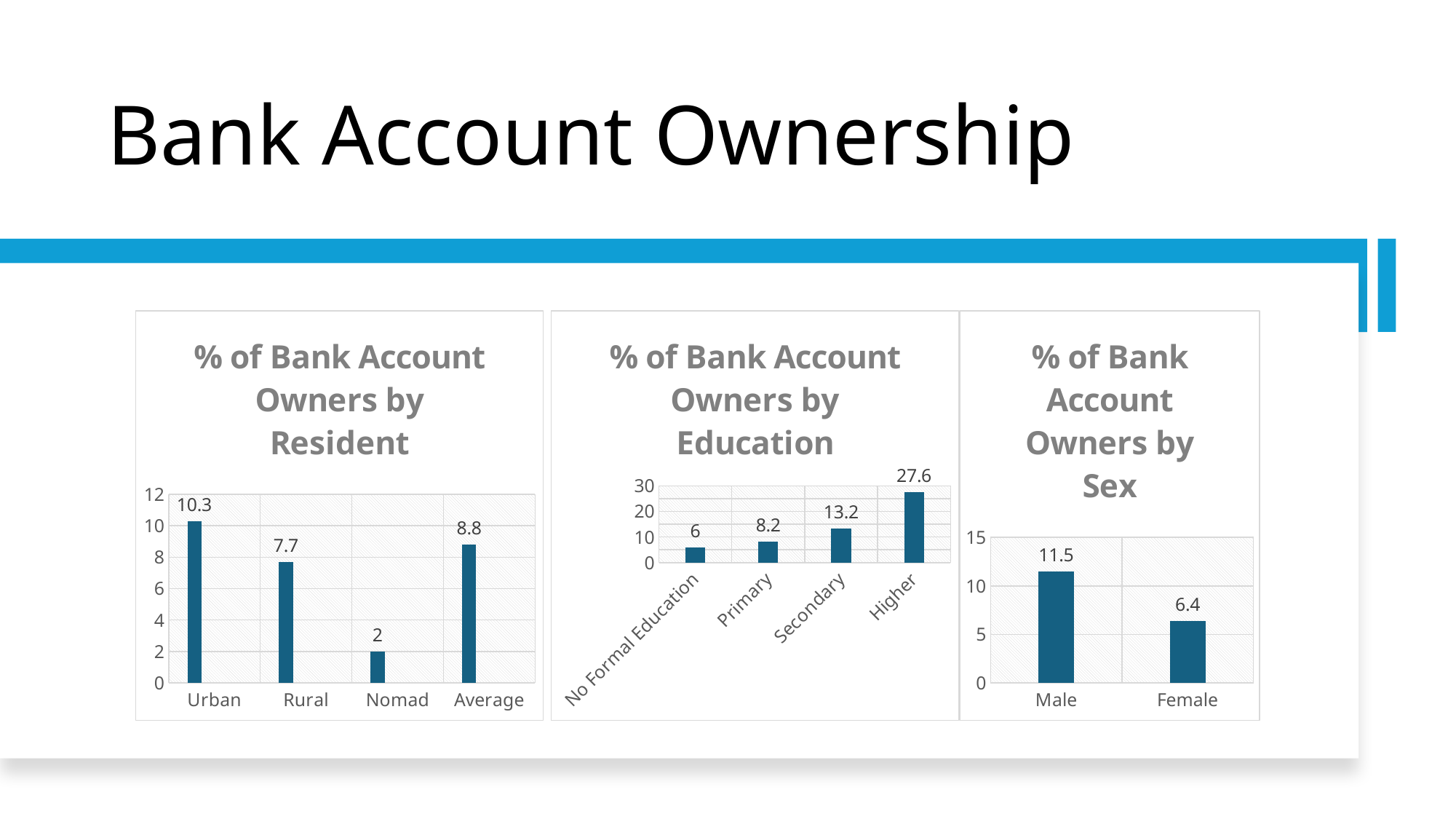
In the '% of Bank Account Owners by Education' chart, which category has the highest value? Higher In the '% of Bank Account Owners by Education' chart, do the values rise or fall from No Formal Education to Higher? rise What kind of chart is the '% of Bank Account Owners by Sex' chart? bar chart In the '% of Bank Account Owners by Resident' chart, which category has the lowest value? Nomad In the '% of Bank Account Owners by Sex' chart, is the value for Male greater or less than 10? greater In the '% of Bank Account Owners by Resident' chart, what is the difference between the Urban and Rural values? 2.6 In the '% of Bank Account Owners by Sex' chart, what is the value for Female? 6.4 In the '% of Bank Account Owners by Resident' chart, what is the value for Urban? 10.3 In the '% of Bank Account Owners by Sex' chart, which is larger, Male or Female? Male In the '% of Bank Account Owners by Education' chart, what is the difference between the Higher and Primary values? 19.4 In the '% of Bank Account Owners by Education' chart, what is the value for Secondary? 13.2 In the '% of Bank Account Owners by Resident' chart, how many categories are shown? 4